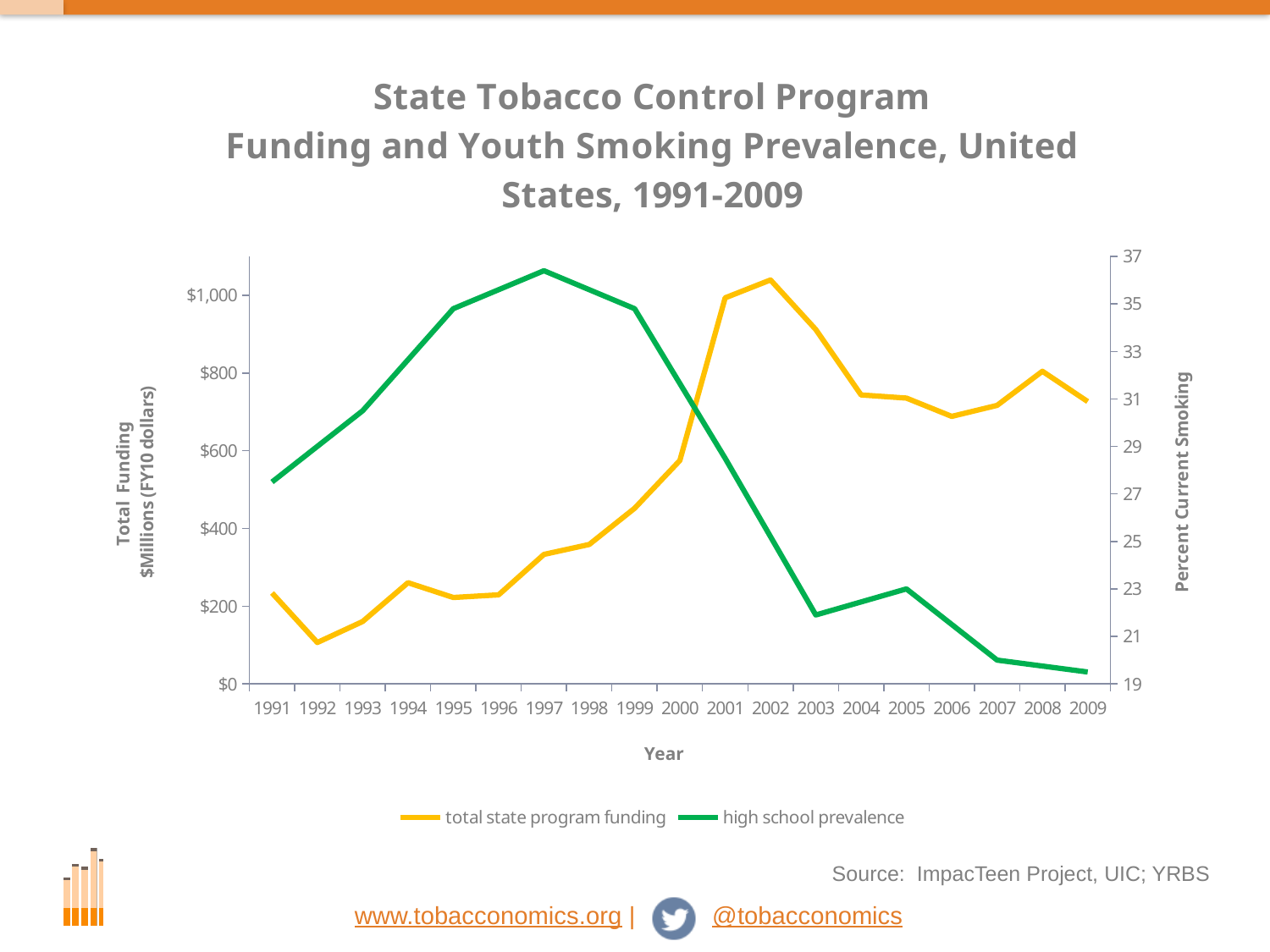
In which year is high school prevalence highest? 1997 In which year is total state program funding lowest? 1992 How many years are plotted along the x axis? 19 Does high school prevalence rise or fall from 1997 to 2009? fall How many series does the legend list? 2 What kind of chart is shown on the slide? line chart What is the label of the right-hand vertical axis? Percent Current Smoking Is the high school prevalence for 2003 greater or less than 25? less Which year has higher total state program funding, 1992 or 1994? 1994 In which year is high school prevalence lowest? 2009 Is the total state program funding for 2001 greater or less than $800? greater In which year is total state program funding highest? 2002